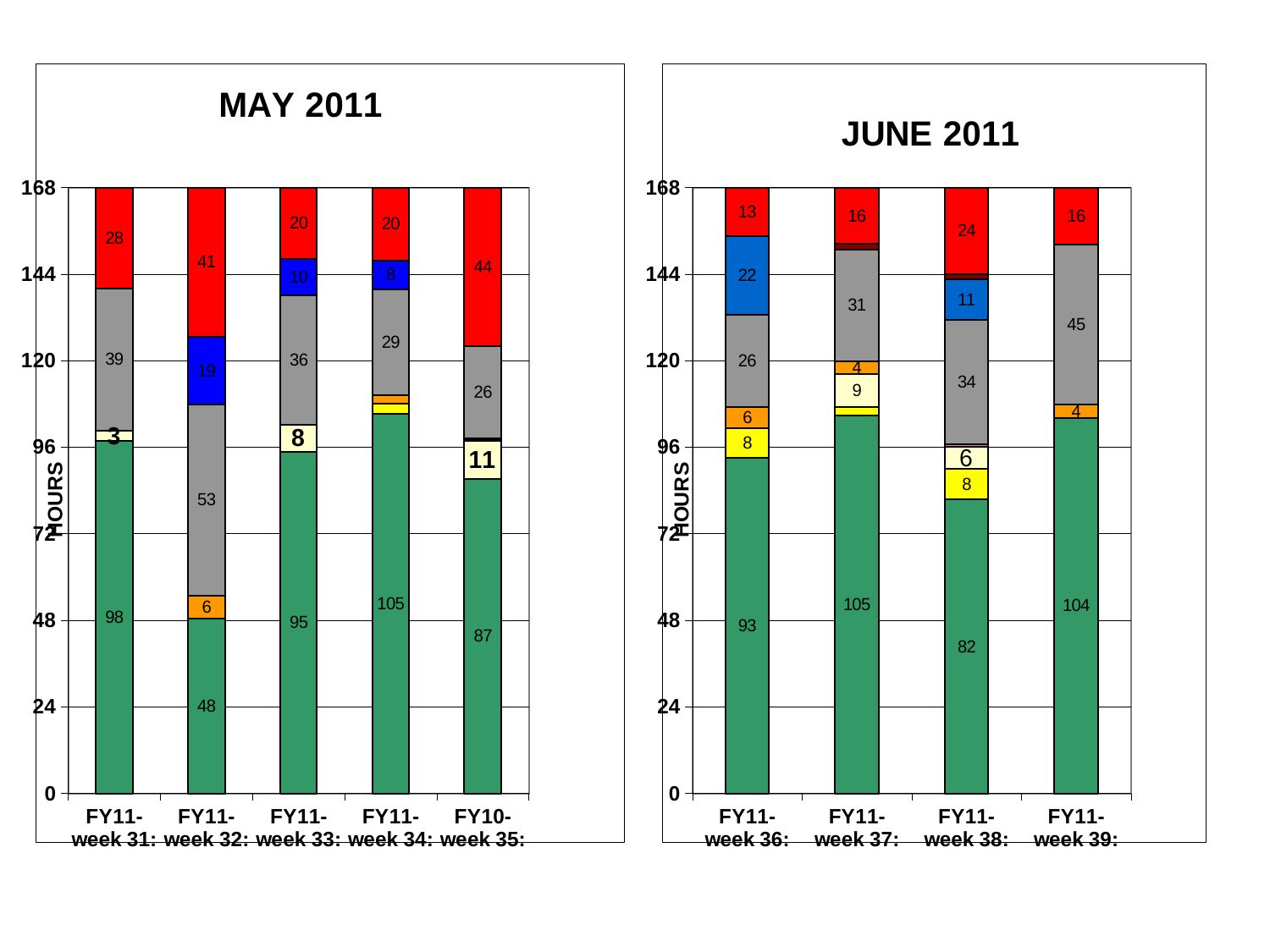
In the MAY 2011 chart, how many weeks are shown on the x axis? 5 In the JUNE 2011 chart, what is the value of the grey segment for FY11-week 39? 45 In the JUNE 2011 chart, how many weeks are shown on the x axis? 4 In the MAY 2011 chart, which week has the largest green segment? FY11-week 34 In the JUNE 2011 chart, which week has the largest grey segment? FY11-week 39 In the MAY 2011 chart, which week has the smallest green segment? FY11-week 32 In the MAY 2011 chart, what is the value of the green segment for FY11-week 32? 48 What kind of chart is the JUNE 2011 chart? Stacked bar chart In the MAY 2011 chart, what is the value of the red segment for FY10-week 35? 44 In the JUNE 2011 chart, which has the larger green segment, FY11-week 36 or FY11-week 37? FY11-week 37 In the JUNE 2011 chart, what is the value of the green segment for FY11-week 38? 82 In the MAY 2011 chart, what is the difference between the green segment for FY11-week 34 and the green segment for FY11-week 32? 57